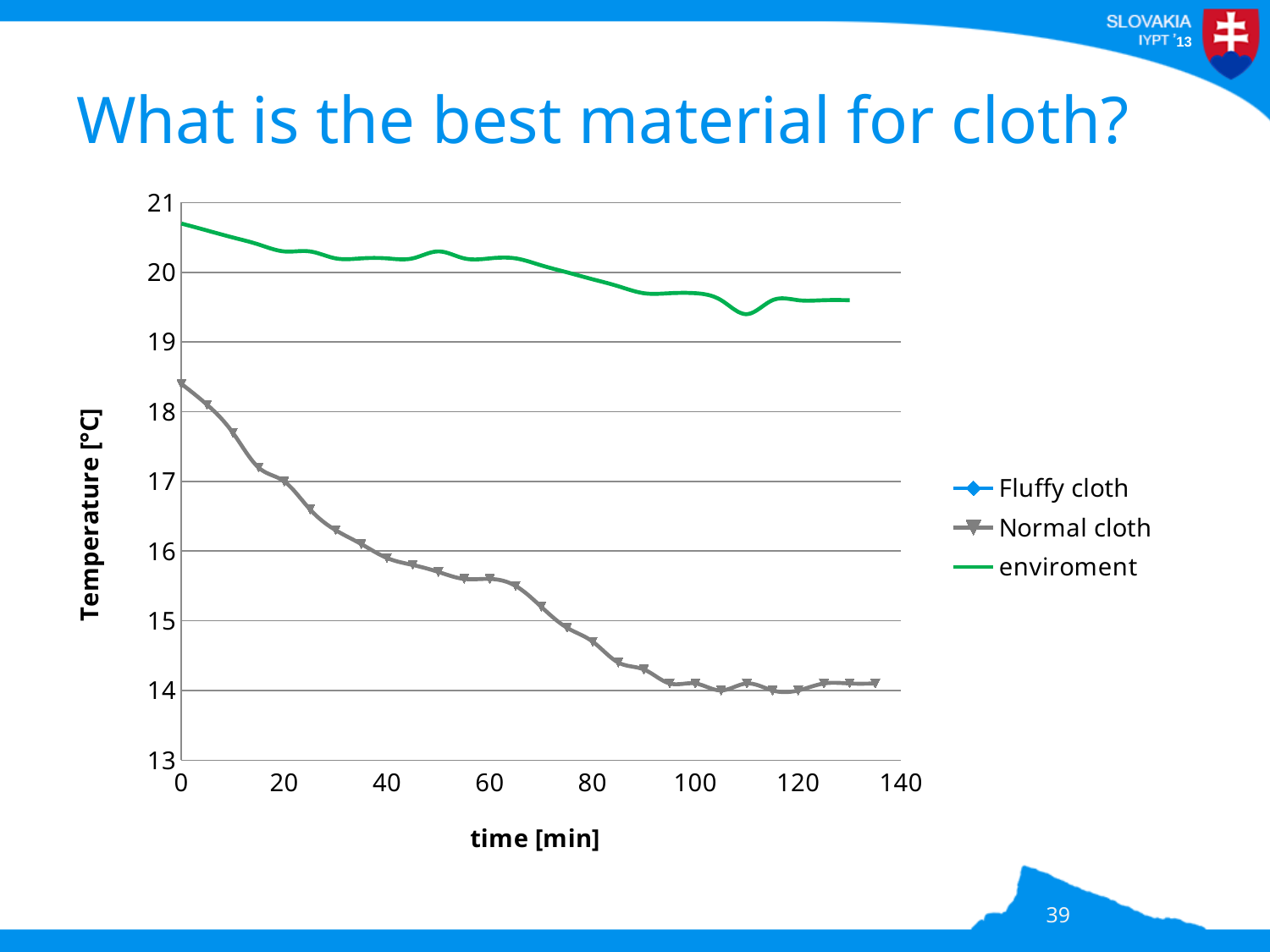
How many series does the legend list? 3 At 60 min, which is higher: the enviroment temperature or the Normal cloth temperature? enviroment Is the Normal cloth temperature at 80 min greater or less than 15? less What is the label of the vertical axis? Temperature [°C] Is the enviroment temperature at 110 min greater or less than 20? less Is the Normal cloth temperature at 60 min greater or less than 16? less What kind of chart is shown on the slide? line chart What is the label of the horizontal axis? time [min] Does the enviroment temperature rise or fall over the time shown? fall Does the Normal cloth temperature rise or fall as time increases? fall